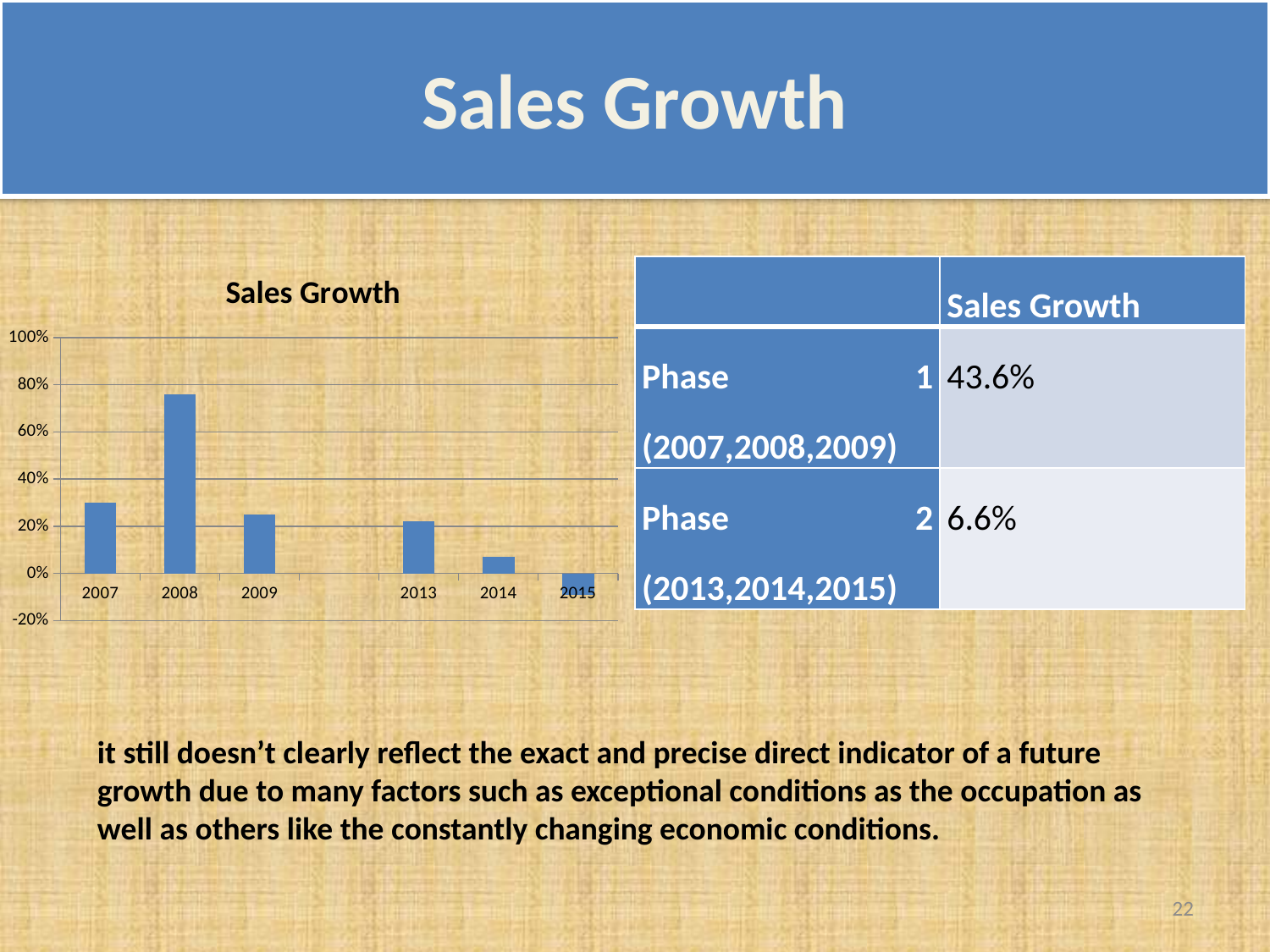
Which year has the highest sales growth in the chart? 2008 Is the value for 2007 greater or less than 40%? less Is the value for 2008 greater or less than 60%? greater Is the value for 2014 greater or less than 20%? less What is the title of the chart? Sales Growth Do the values rise or fall from 2013 to 2015? fall Which year has the larger sales growth, 2007 or 2014? 2007 How many years are shown on the x axis of the chart? 6 What kind of chart is shown on the slide? bar chart Which year has the lowest sales growth in the chart? 2015 Which year has the larger sales growth, 2008 or 2013? 2008